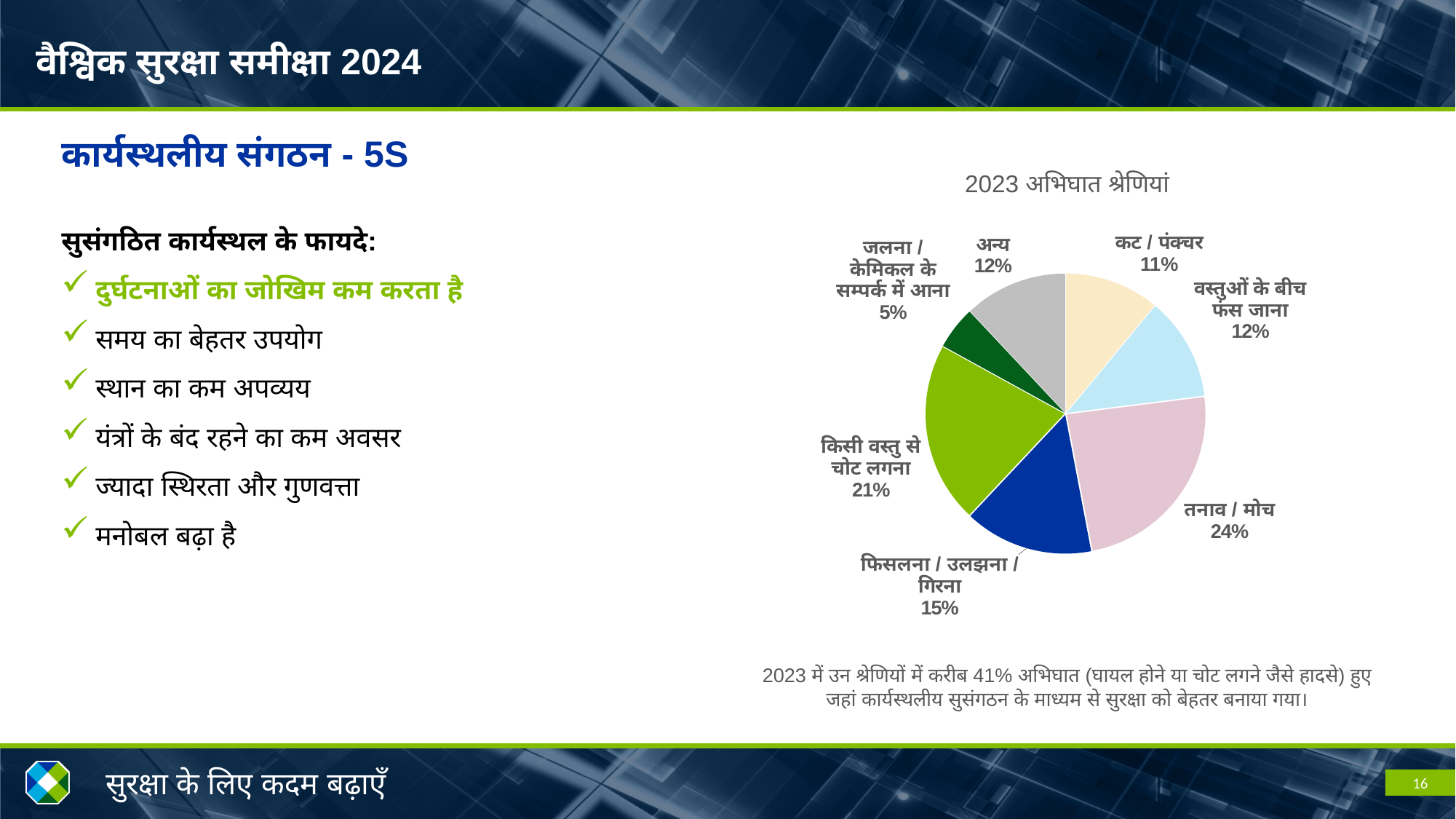
पाई चार्ट में तनाव / मोच का हिस्सा कितना है? 24% पाई चार्ट में जलना / केमिकल के सम्पर्क में आना का हिस्सा कितना है? 5% पाई चार्ट में फिसलना / उलझना / गिरना का हिस्सा कितना है? 15% किसी वस्तु से चोट लगना और कट / पंक्चर में से किसका हिस्सा बड़ा है? किसी वस्तु से चोट लगना चार्ट का शीर्षक क्या है? 2023 अभिघात श्रेणियां पाई चार्ट में सबसे बड़ा हिस्सा किस श्रेणी का है? तनाव / मोच पाई चार्ट में कट / पंक्चर का हिस्सा कितना है? 11% तनाव / मोच और फिसलना / उलझना / गिरना के हिस्सों में कितना अंतर है? 9 प्रतिशत अंक पाई चार्ट में कुल कितनी श्रेणियां दिखाई गई हैं? 7 स्लाइड पर दिखाया गया चार्ट किस प्रकार का है? पाई चार्ट पाई चार्ट में किसी वस्तु से चोट लगना का हिस्सा कितना है? 21% पाई चार्ट में सबसे छोटा हिस्सा किस श्रेणी का है? जलना / केमिकल के सम्पर्क में आना